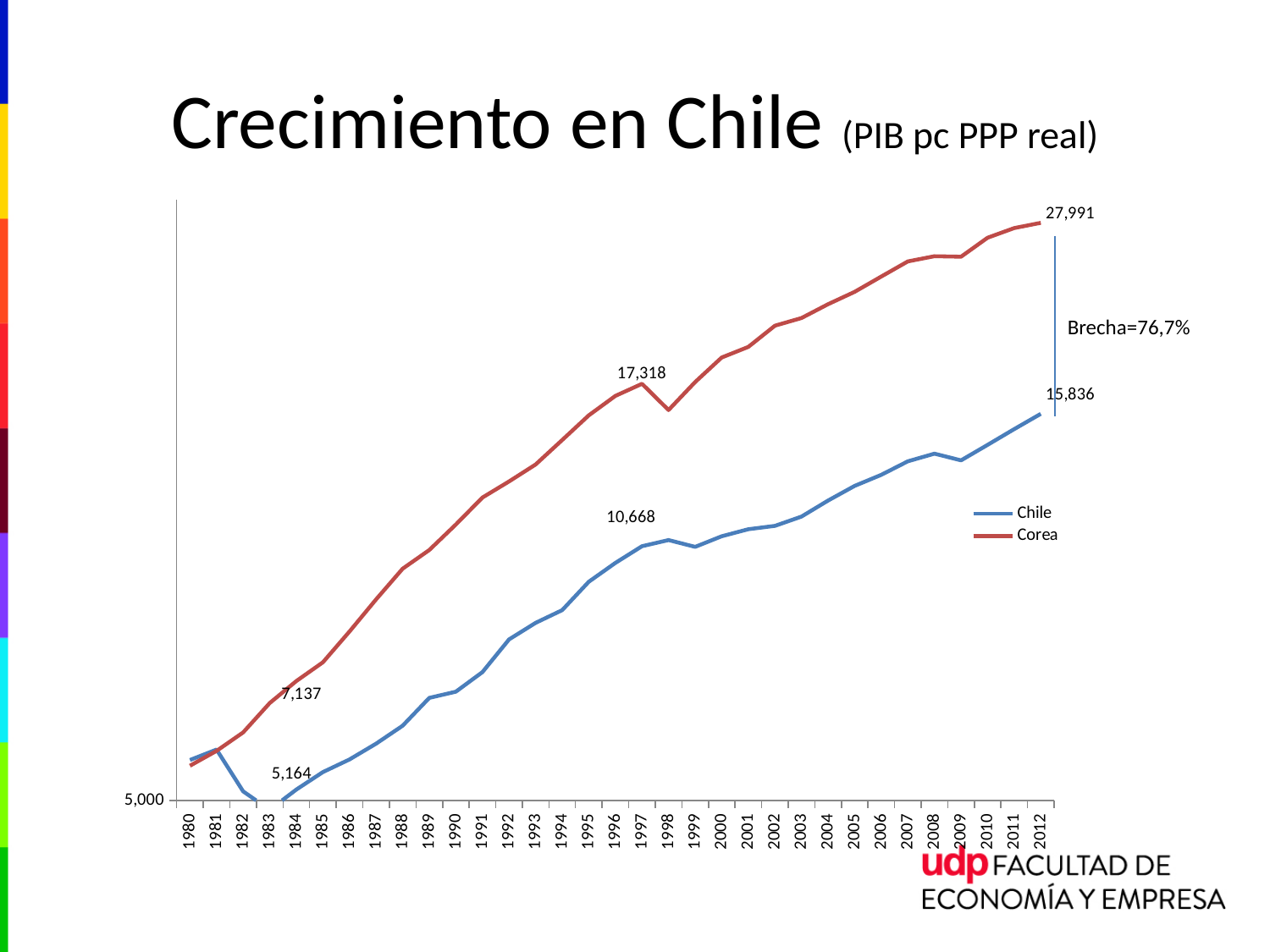
What is the 'Brecha' (gap) percentage shown on the chart? 76,7% Which two series are listed in the legend? Chile and Corea Which series has the higher value in 2012, Chile or Corea? Corea How many series does the legend list? 2 What is the value labelled for Corea in 2012? 27,991 What type of chart is shown on the slide? line chart What is the difference between the 2012 values of Corea and Chile? 12,155 Do the values for Corea generally rise or fall from 1980 to 2012? rise Which series reaches the highest value on the chart? Corea How many years are shown on the x axis? 33 What is the value labelled for Chile in 2012? 15,836 What is the first year shown on the x axis? 1980